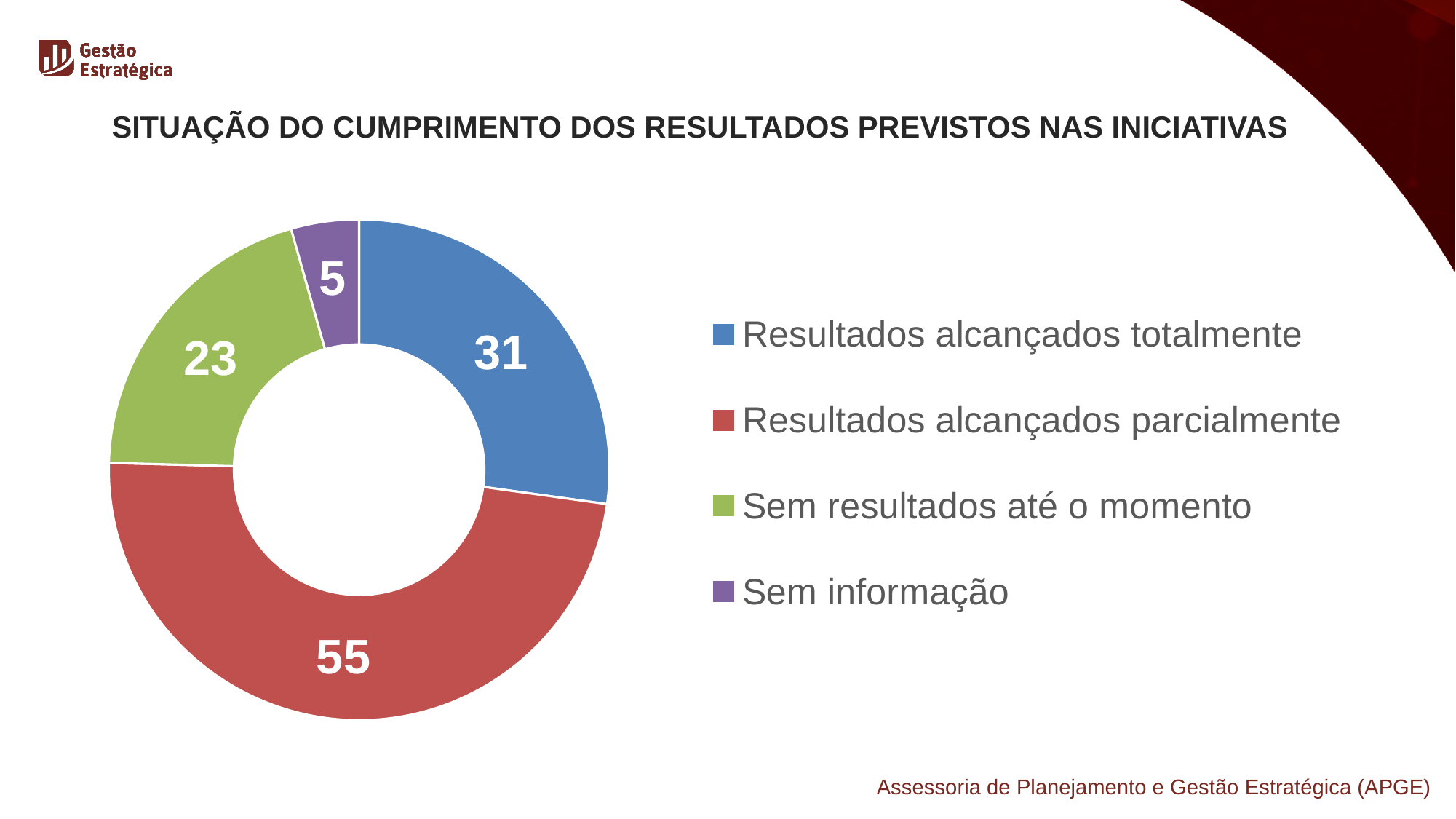
What kind of chart is shown on the slide? Doughnut chart Which category has the largest value? Resultados alcançados parcialmente How many categories does the chart show? 4 What value is shown for "Sem resultados até o momento"? 23 What is the difference between the values for "Resultados alcançados parcialmente" and "Resultados alcançados totalmente"? 24 What colour represents "Sem resultados até o momento" in the chart? Green Which is larger: the value for "Resultados alcançados totalmente" or for "Sem resultados até o momento"? Resultados alcançados totalmente What value is shown for "Resultados alcançados totalmente"? 31 What is the total of all the values shown in the chart? 114 What value is shown for "Resultados alcançados parcialmente"? 55 What value is shown for "Sem informação"? 5 Which category has the smallest value? Sem informação